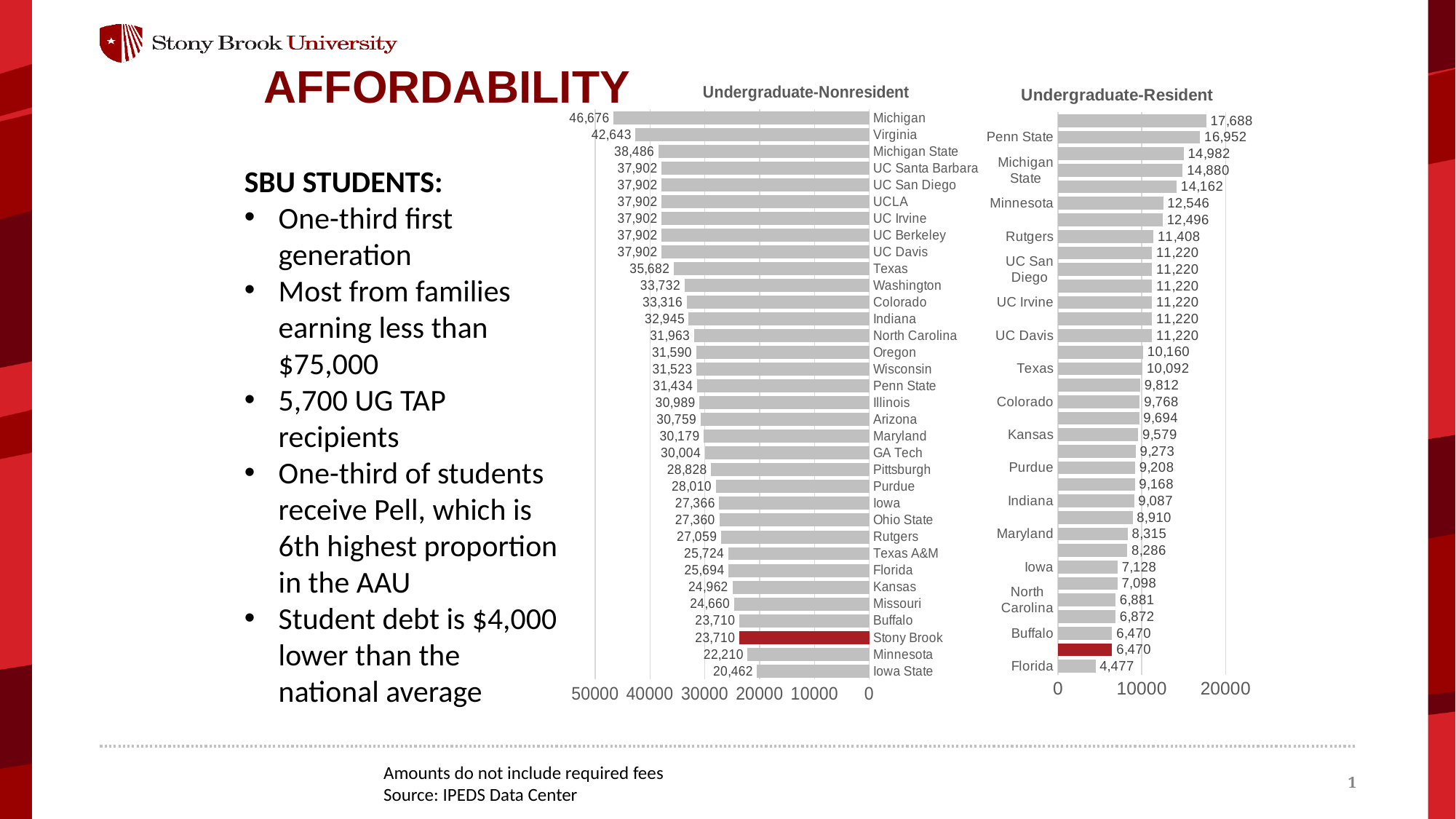
In the Undergraduate-Nonresident chart, what is the value for Stony Brook? 23,710 What kind of chart is the Undergraduate-Resident chart? Bar chart In the Undergraduate-Nonresident chart, which is larger, Texas or Washington? Texas In the Undergraduate-Resident chart, what is the difference between Penn State and Florida? 12,475 In the Undergraduate-Resident chart, what is the value for Penn State? 16,952 In the Undergraduate-Resident chart, which university has the lowest value? Florida In the Undergraduate-Nonresident chart, which university has the lowest value? Iowa State In the Undergraduate-Nonresident chart, what is the difference between Michigan and Virginia? 4,033 In the Undergraduate-Nonresident chart, which university has the highest value? Michigan How many universities are shown in the Undergraduate-Nonresident chart? 34 In the Undergraduate-Nonresident chart, which university's bar is highlighted in red? Stony Brook In the Undergraduate-Resident chart, what is the value for Florida? 4,477